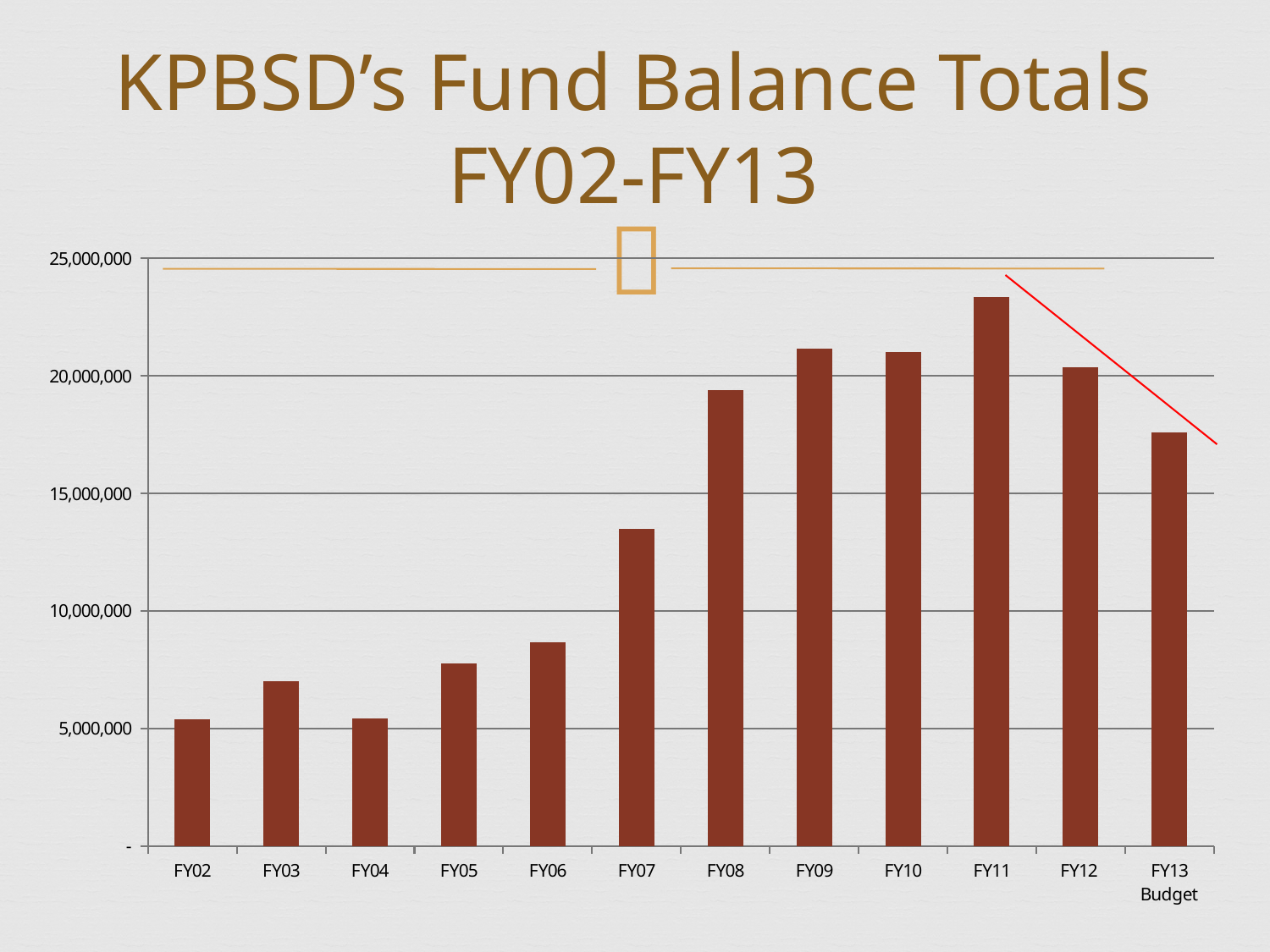
What kind of chart is shown on the slide? bar chart Is the fund balance total for FY07 greater or less than 15,000,000? less Do the fund balance totals generally rise or fall from FY04 to FY11? rise Which is larger, the fund balance total for FY07 or for FY08? FY08 What is the title of the chart on the slide? KPBSD's Fund Balance Totals FY02-FY13 Do the fund balance totals rise or fall from FY11 to FY13 Budget? fall Is the fund balance total for FY13 Budget greater or less than 15,000,000? greater Which is larger, the fund balance total for FY11 or for FY12? FY11 How many fiscal years (bars) are plotted in the chart? 12 Is the fund balance total for FY11 greater or less than 20,000,000? greater Which fiscal year has the highest fund balance total? FY11